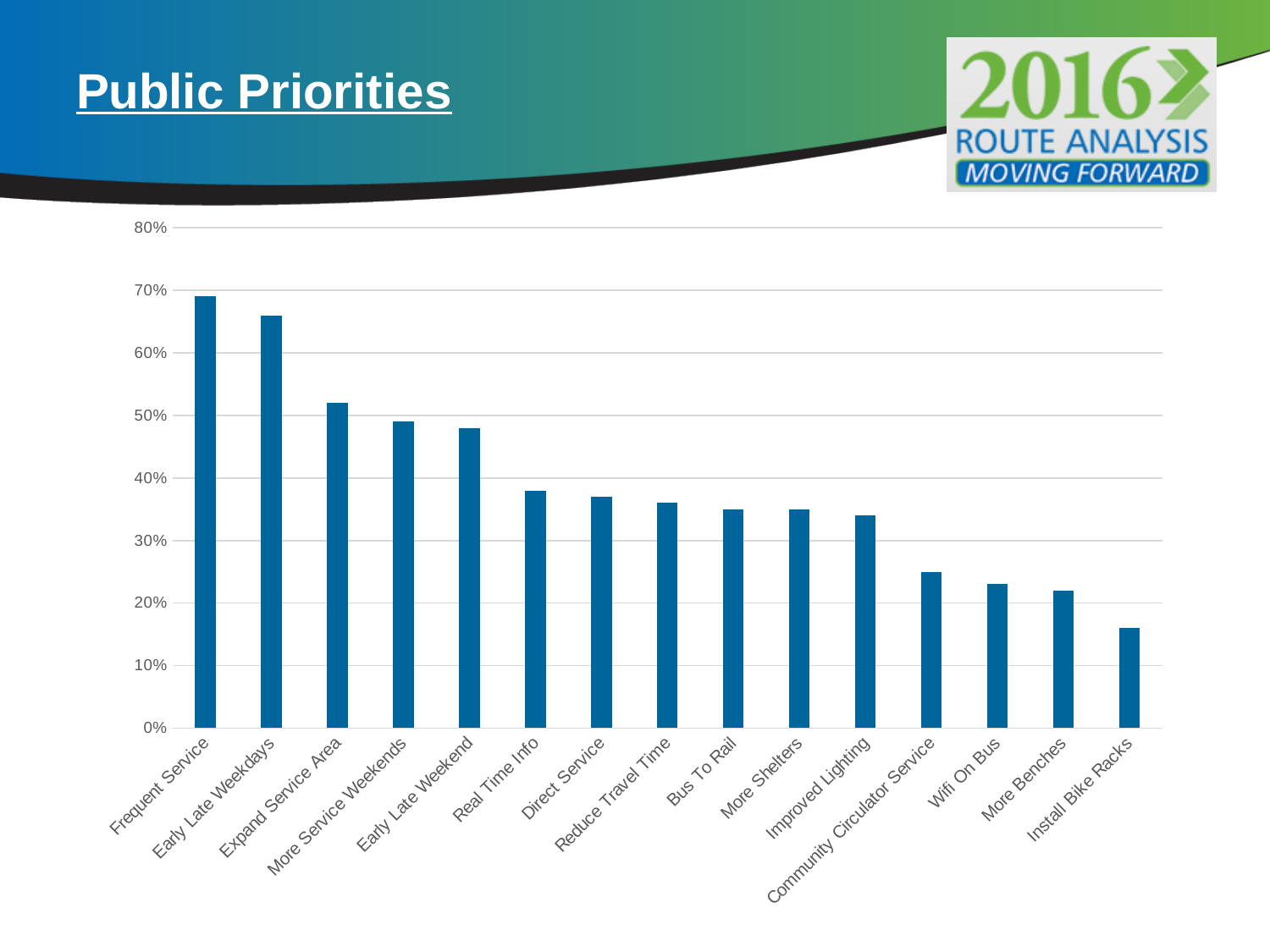
Do the values generally rise or fall moving from left to right along the x axis? fall Is the value for Community Circulator Service greater or less than 30%? less What is the title of the slide containing the chart? Public Priorities How many categories are plotted on the chart? 15 Which is larger, the value for Expand Service Area or the value for Real Time Info? Expand Service Area Is the value for Improved Lighting greater or less than 30%? greater Is the value for Install Bike Racks greater or less than 20%? less Which is larger, the value for More Benches or the value for Early Late Weekend? Early Late Weekend Which category has the lowest value? Install Bike Racks Which category has the highest value? Frequent Service What kind of chart is shown on the slide? Bar chart